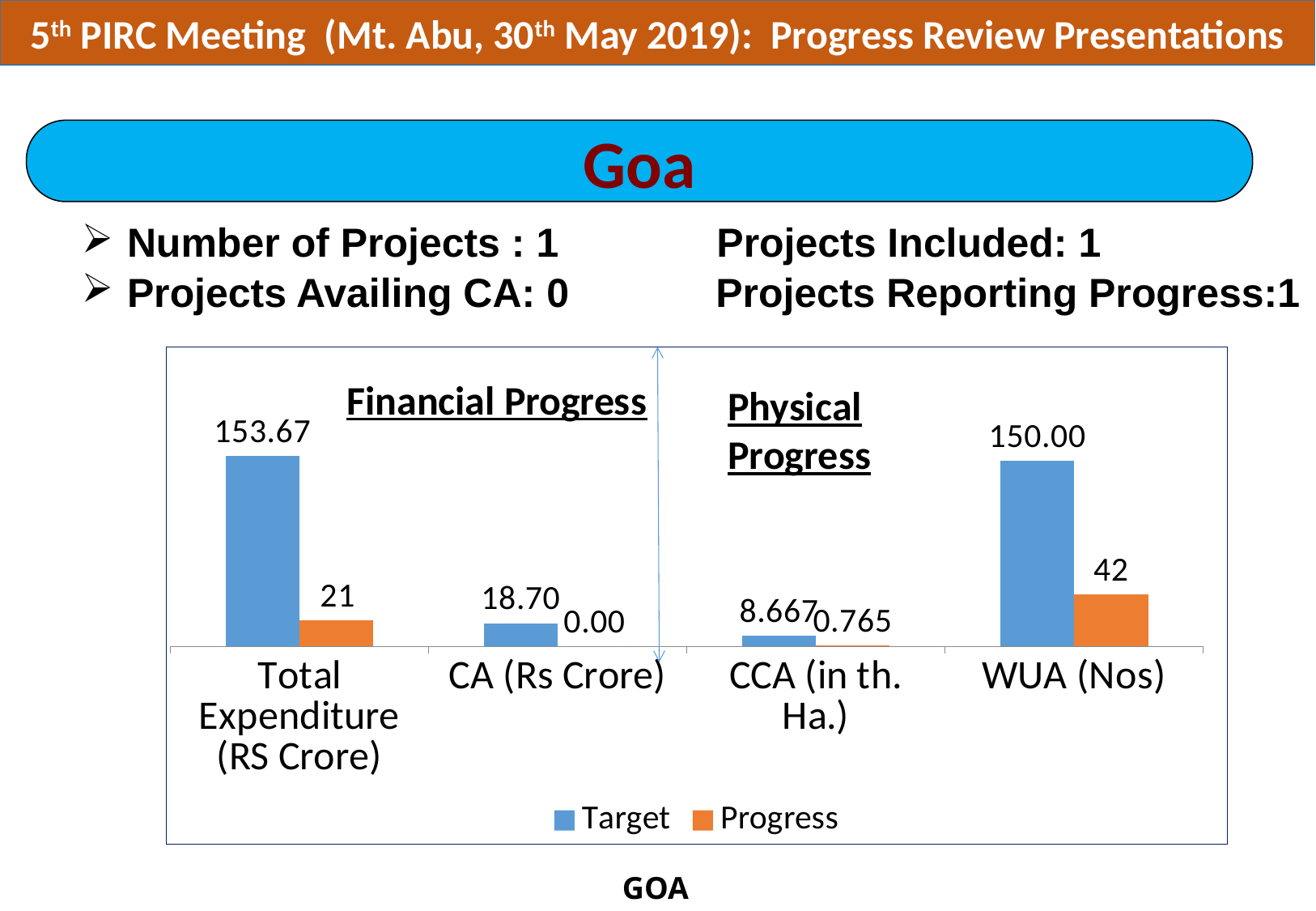
What is the Target value for CCA (in th. Ha.)? 8.667 How many categories are shown on the x axis of the chart? 4 Which category has the highest Target value? Total Expenditure (RS Crore) What is the Progress value for WUA (Nos)? 42 What is the Target value for Total Expenditure (RS Crore)? 153.67 Which is larger, the Progress value for Total Expenditure (RS Crore) or the Progress value for WUA (Nos)? WUA (Nos) What kind of chart is shown on the slide? Bar chart Which category has the lowest Progress value? CA (Rs Crore) What is the difference between the Target and Progress values for WUA (Nos)? 108.00 What is the Progress value for CA (Rs Crore)? 0.00 Which colour represents the Progress series in the chart? Orange How many series does the chart legend list? 2